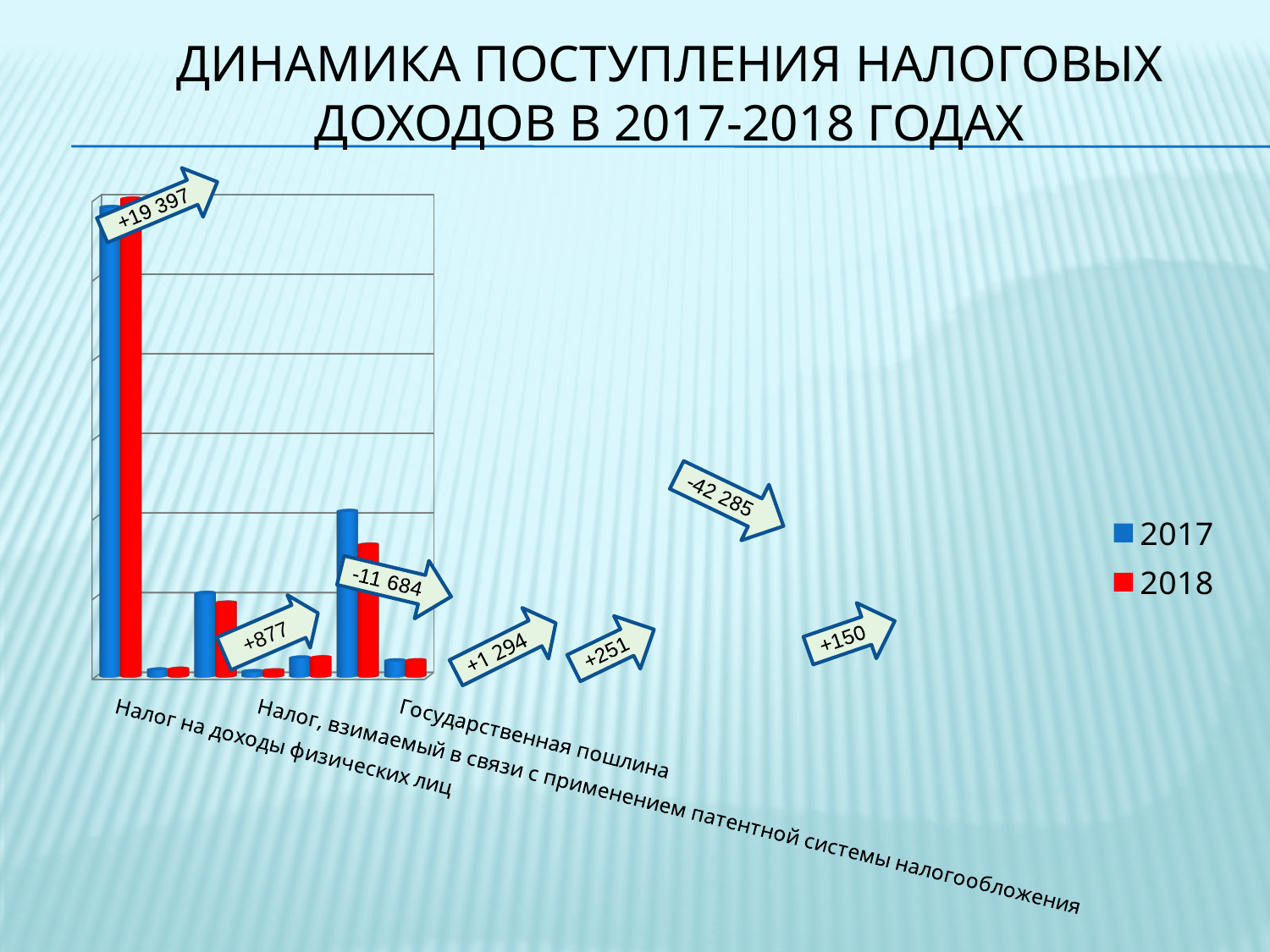
Which colour represents the 2018 series in the chart? red Which group of bars is the tallest in the chart, counting from the left? the first group Which years are listed in the chart legend? 2017 and 2018 How many groups of bars (categories) are plotted in the chart? 7 In the sixth group of bars from the left, which series has the taller bar, 2017 or 2018? 2017 What kind of chart is shown on the slide? bar chart How many series does the legend list? 2